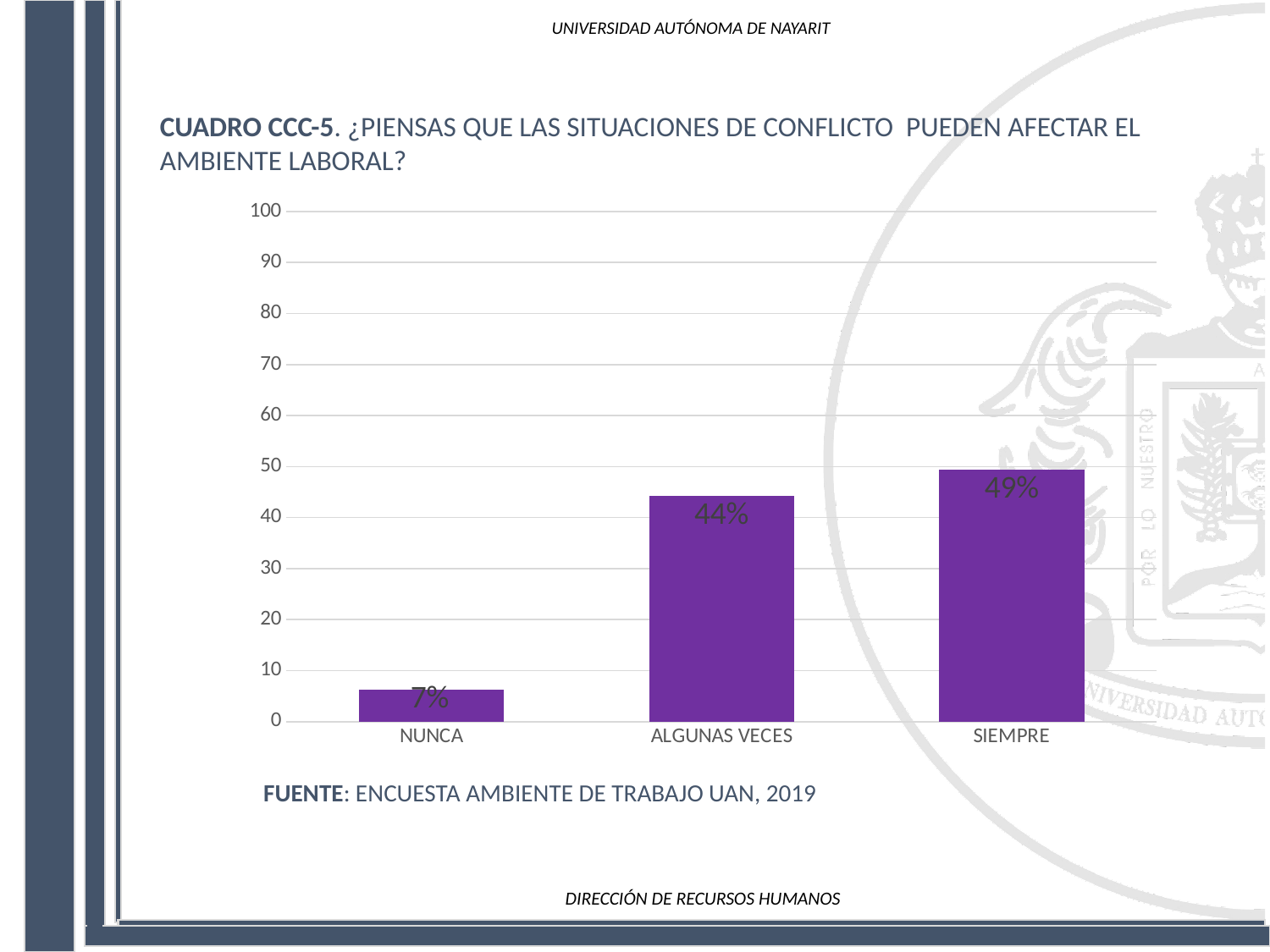
Is the value for SIEMPRE greater or less than 50? less Which category has the highest value? SIEMPRE How many categories are shown on the x axis? 3 What is the difference between the values for SIEMPRE and ALGUNAS VECES? 5% Which is larger, the value for NUNCA or the value for ALGUNAS VECES? ALGUNAS VECES What is the value for NUNCA? 7% What is the difference between the values for ALGUNAS VECES and NUNCA? 37% Which category has the lowest value? NUNCA What is the value for ALGUNAS VECES? 44% What kind of chart is shown on the slide? bar chart Do the values rise or fall from NUNCA to SIEMPRE along the x axis? rise What is the value for SIEMPRE? 49%